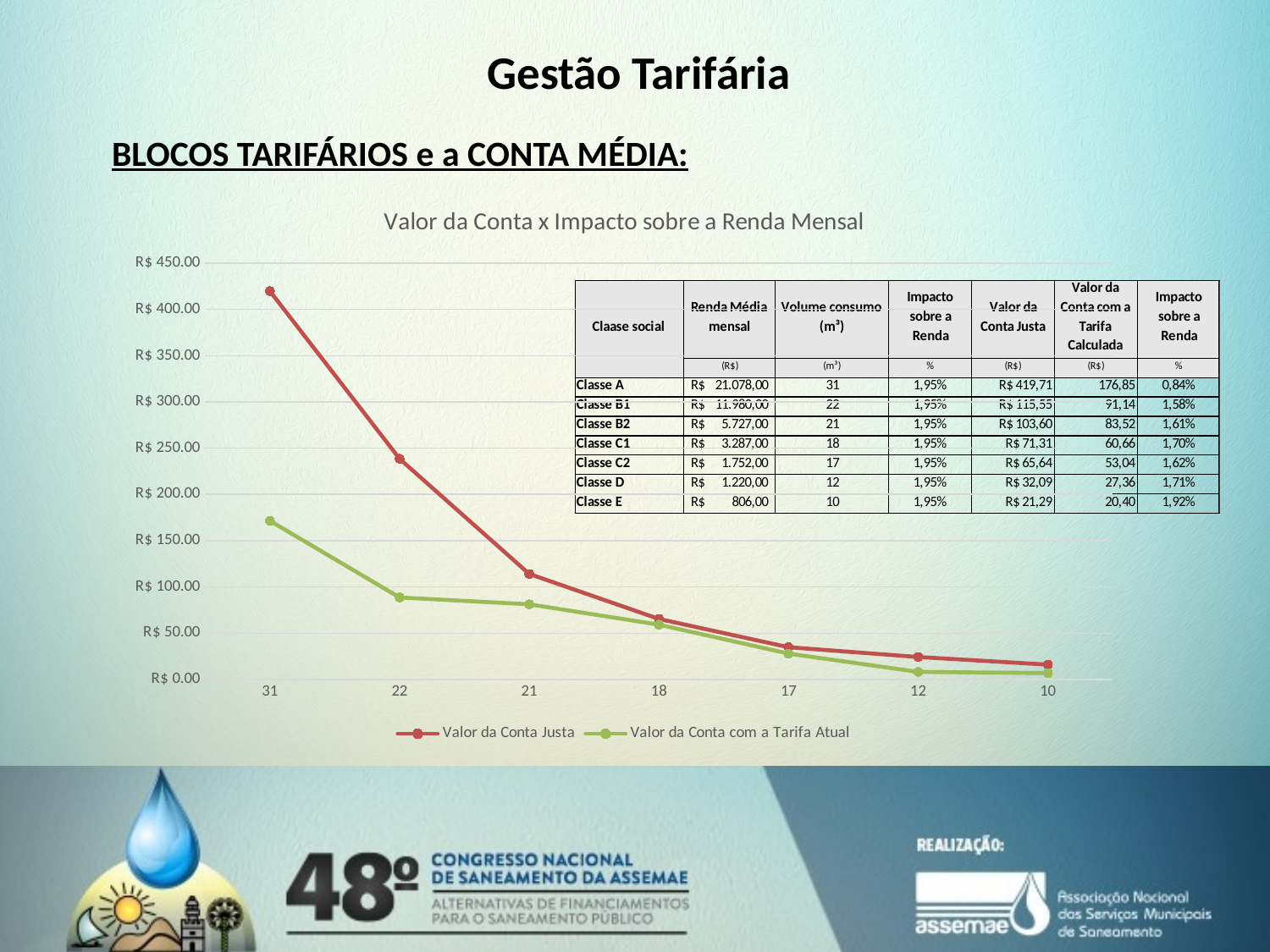
What kind of chart is shown on the slide? Line chart How many series does the chart legend list? 2 Is the value for Valor da Conta com a Tarifa Atual at 31 greater or less than R$ 200.00? less At which x-axis value is Valor da Conta Justa highest? 31 Is the value for Valor da Conta Justa at 21 greater or less than R$ 150.00? less At which x-axis value is Valor da Conta Justa lowest? 10 What is the title of the chart? Valor da Conta x Impacto sobre a Renda Mensal Do the values of Valor da Conta Justa rise or fall from left to right along the x axis? Fall At x-axis value 22, which series has the higher value: Valor da Conta Justa or Valor da Conta com a Tarifa Atual? Valor da Conta Justa Is the value for Valor da Conta Justa at 31 greater or less than R$ 400.00? greater How many points are plotted along the x axis for each series? 7